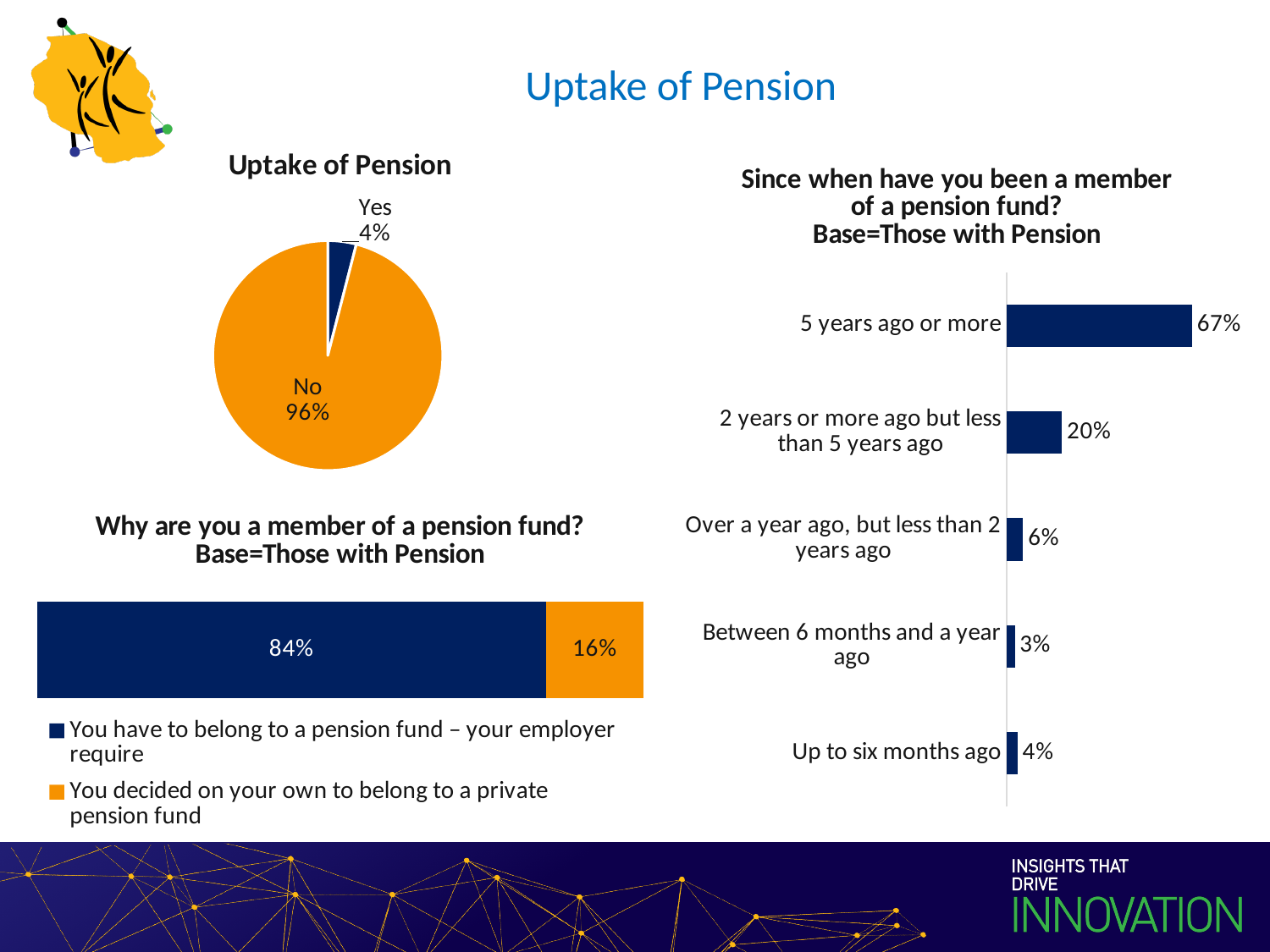
In the 'Why are you a member of a pension fund?' chart, what percentage chose 'You have to belong to a pension fund – your employer require'? 84% In the 'Uptake of Pension' pie chart, what percentage answered No? 96% How many categories are shown in the 'Since when have you been a member of a pension fund?' chart? 5 In the 'Why are you a member of a pension fund?' chart, which is larger: 'You have to belong to a pension fund – your employer require' or 'You decided on your own to belong to a private pension fund'? You have to belong to a pension fund – your employer require In the 'Since when have you been a member of a pension fund?' chart, what is the value for 'Between 6 months and a year ago'? 3% In the 'Since when have you been a member of a pension fund?' chart, what is the value for '5 years ago or more'? 67% In the 'Since when have you been a member of a pension fund?' chart, which category has the lowest value? Between 6 months and a year ago What kind of chart is the 'Uptake of Pension' chart? Pie chart In the 'Since when have you been a member of a pension fund?' chart, which category has the highest value? 5 years ago or more What kind of chart is the 'Since when have you been a member of a pension fund?' chart? Bar chart In the 'Since when have you been a member of a pension fund?' chart, what is the difference between '5 years ago or more' and '2 years or more ago but less than 5 years ago'? 47% In the 'Uptake of Pension' pie chart, what percentage answered Yes? 4%